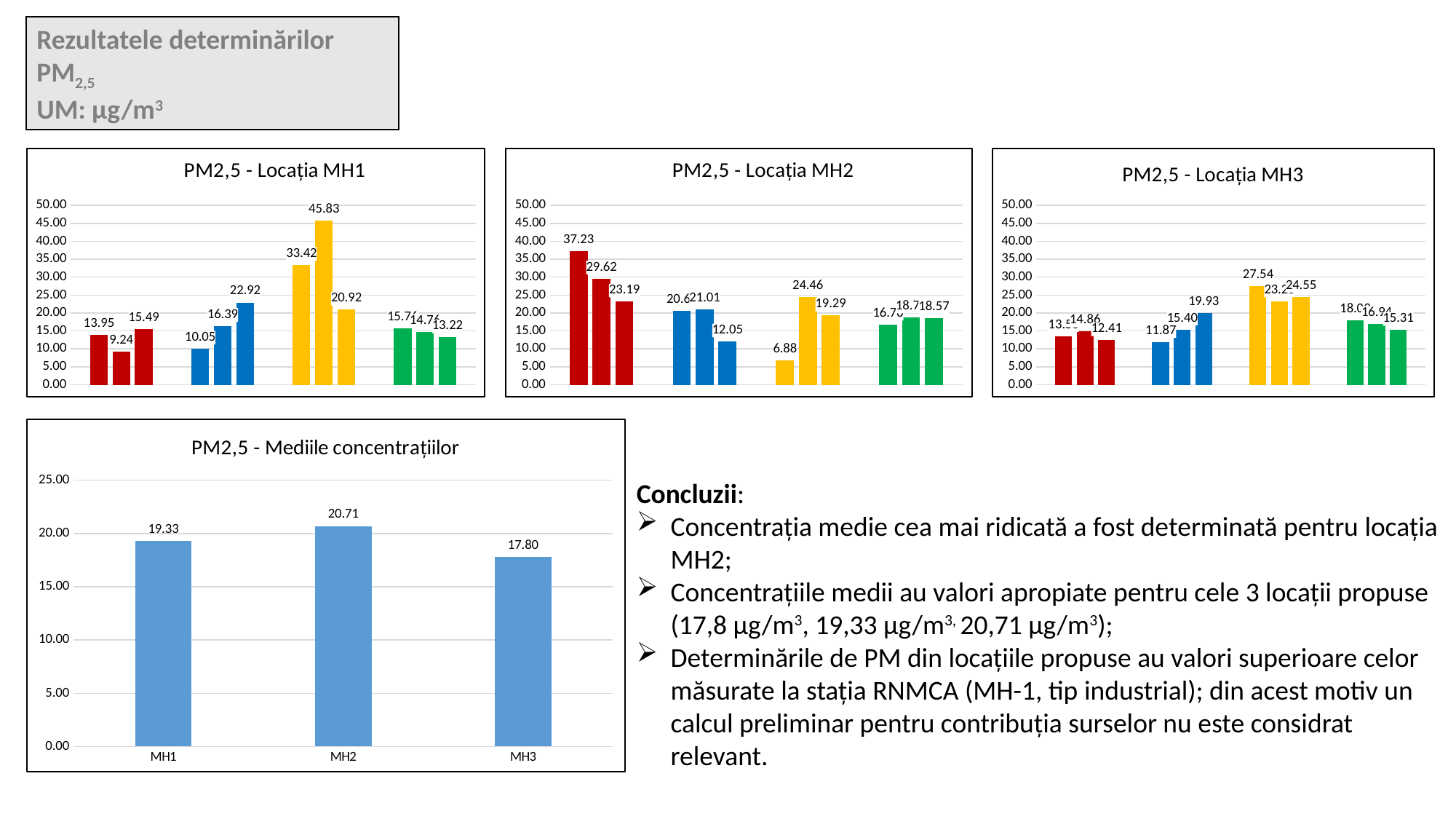
In the chart 'PM2,5 - Locația MH2', what is the lowest value labelled on any bar? 6.88 In the chart 'PM2,5 - Locația MH1', what is the lowest value labelled on any bar? 9.24 In the chart 'PM2,5 - Mediile concentrațiilor', how many locations are shown on the x axis? 3 In the chart 'PM2,5 - Mediile concentrațiilor', what is the value for MH3? 17.80 In the chart 'PM2,5 - Locația MH3', what is the highest value labelled on any bar? 27.54 In the chart 'PM2,5 - Mediile concentrațiilor', which location has the lowest value? MH3 In the chart 'PM2,5 - Locația MH2', what is the highest value labelled on any bar? 37.23 In the chart 'PM2,5 - Mediile concentrațiilor', what is the difference between the values for MH2 and MH1? 1.38 In the chart 'PM2,5 - Mediile concentrațiilor', what is the value for MH2? 20.71 In the chart 'PM2,5 - Mediile concentrațiilor', which location has the highest value? MH2 What kind of chart is 'PM2,5 - Mediile concentrațiilor'? bar chart